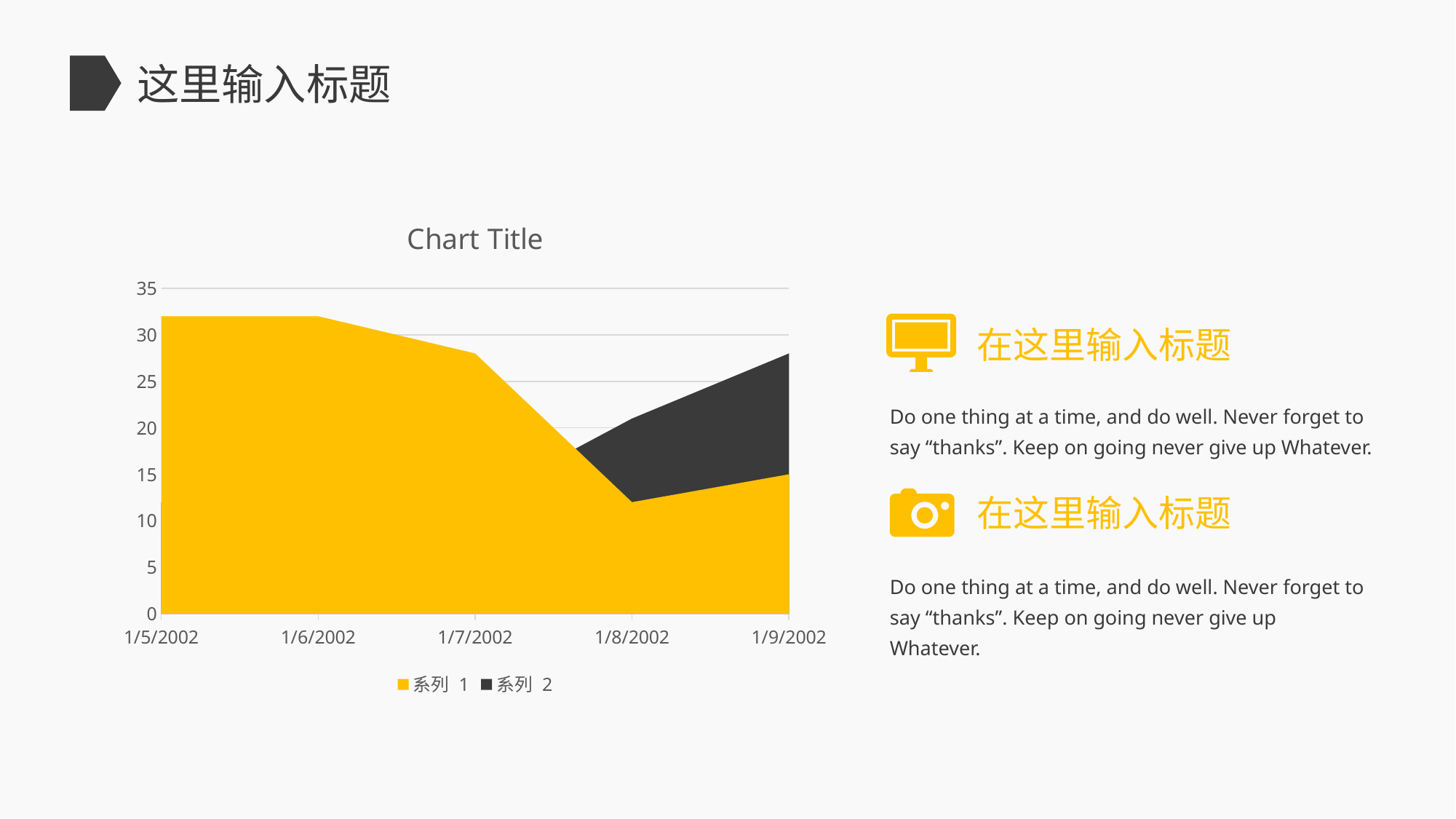
Which colour represents 系列 1 in the chart? Yellow How many series does the chart legend list? 2 What is the title of the chart? Chart Title Is the value for 系列 2 at 1/9/2002 greater or less than 25? greater What kind of chart is shown on the slide? Area chart Does 系列 2 rise or fall from 1/8/2002 to 1/9/2002? Rise Is the value for 系列 1 at 1/7/2002 greater or less than 25? greater Is the value for 系列 1 at 1/8/2002 greater or less than 15? less How many dates are shown on the x axis of the chart? 5 Does 系列 1 rise or fall from 1/5/2002 to 1/8/2002? Fall